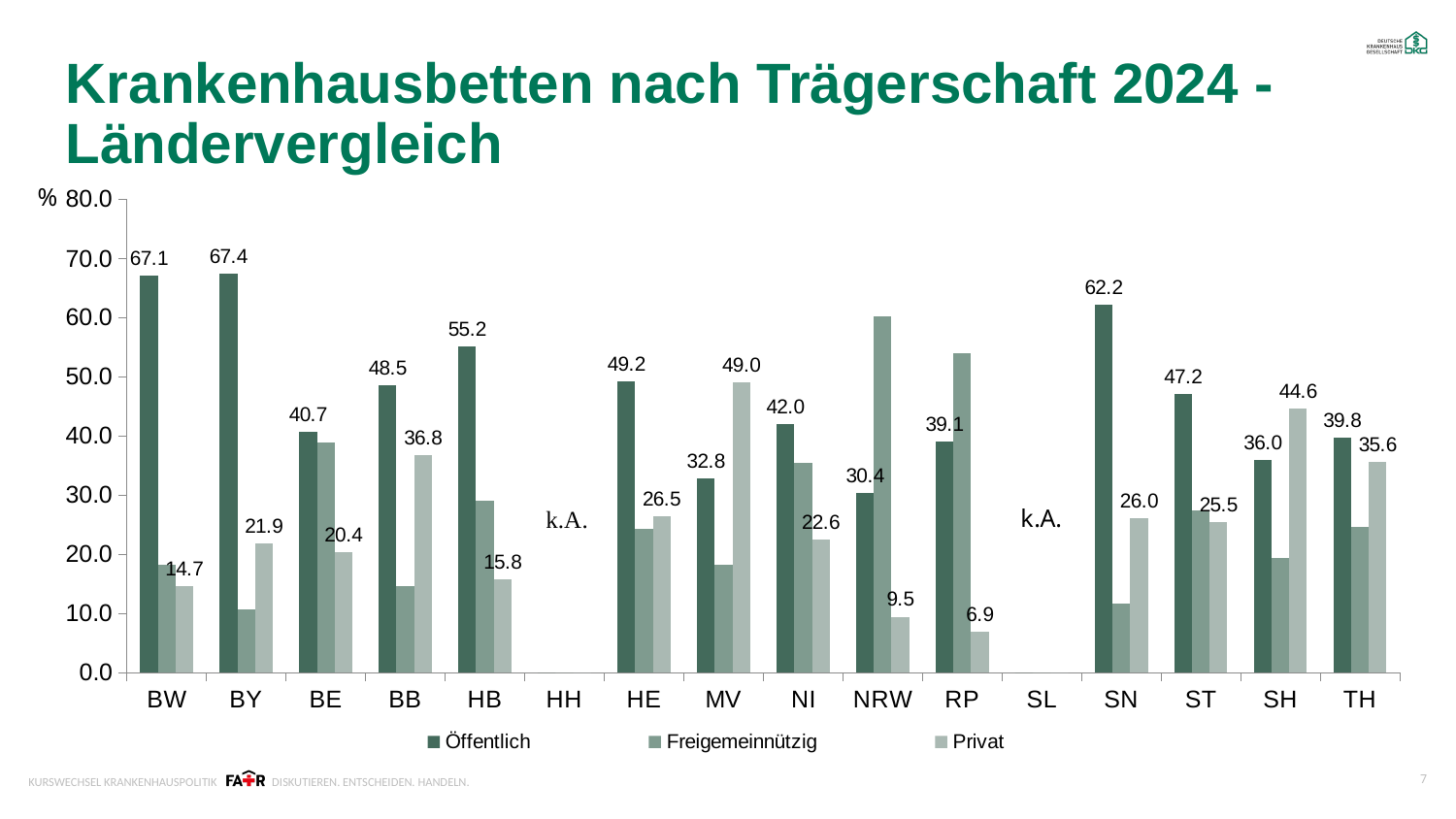
What is the difference between the Privat and Öffentlich values for SH? 8.6 Which state has the lowest Privat value? RP Is the Freigemeinnützig value for NRW greater or less than 50? greater What is the value for Privat in MV? 49.0 In MV, which is larger: Öffentlich or Privat? Privat Is the Freigemeinnützig value for BY greater or less than 20? less How many series does the legend list? 3 What is the difference between the Öffentlich and Privat values for SN? 36.2 Which states are marked with k.A. instead of bars? HH and SL What is the value for Öffentlich in SN? 62.2 Which state has the highest Öffentlich value? BY What is the value for Öffentlich in BW? 67.1